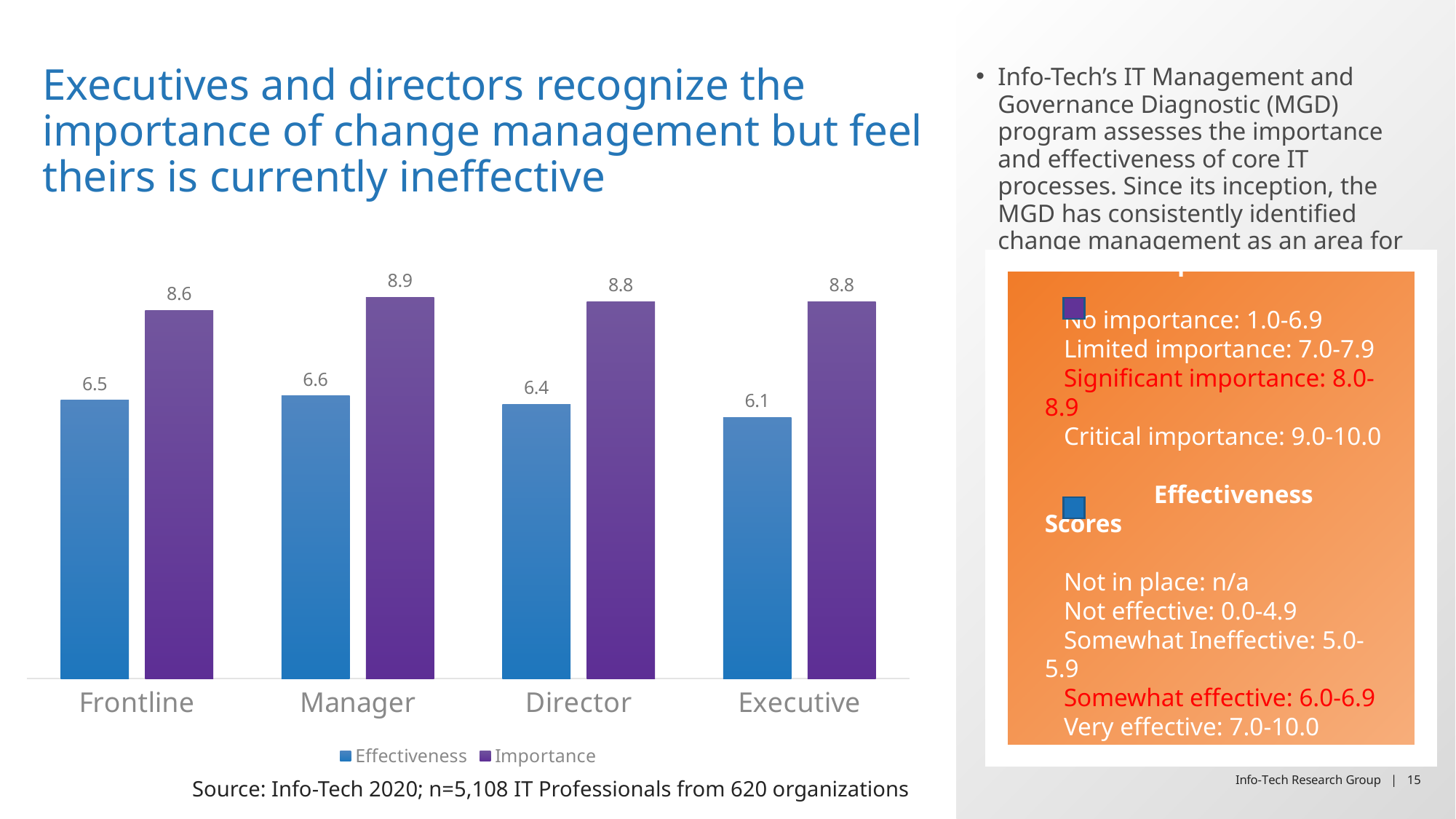
Which is larger, the Effectiveness value for Manager or the Effectiveness value for Director? Manager How many categories are shown on the x axis? 4 What is the Effectiveness value for Frontline? 6.5 What is the Importance value for Manager? 8.9 Which category has the lowest Effectiveness value? Executive How many series does the legend list? 2 What is the Effectiveness value for Executive? 6.1 What is the Importance value for Director? 8.8 What is the difference between the Importance and Effectiveness values for Executive? 2.7 What are the two series named in the legend? Effectiveness and Importance Which category has the highest Importance value? Manager What kind of chart is shown on the slide? Bar chart